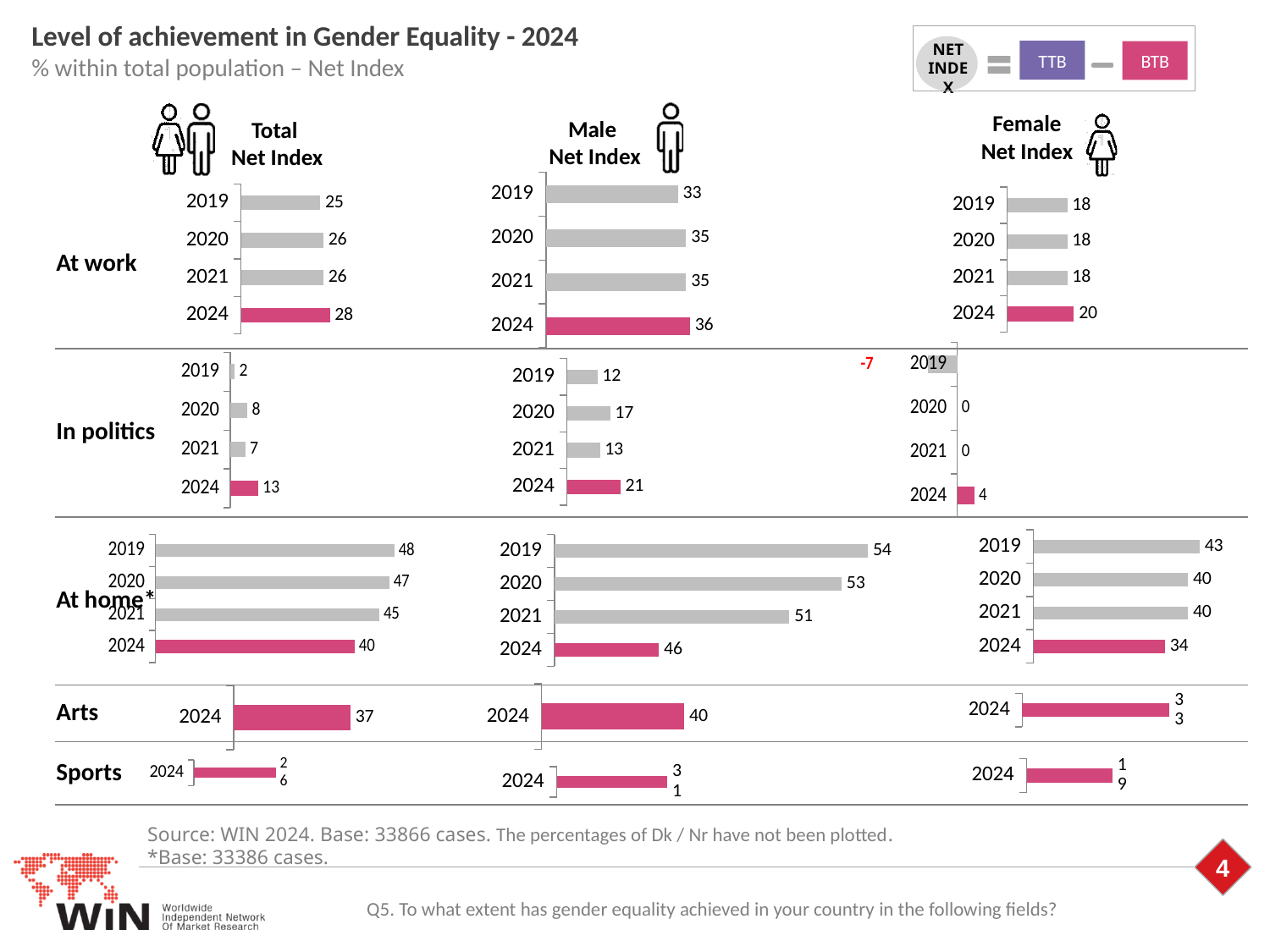
In the At home* row, Male Net Index chart, what is the difference between the 2019 and 2024 values? 8 In the At home* row, Female Net Index chart, do the values rise or fall from 2019 to 2024? fall In the In politics row, Total Net Index chart, which year has the highest value? 2024 In the At work row, Total Net Index chart, what is the value for 2024? 28 What kind of chart is used throughout the slide? bar chart In the In politics row, Total Net Index chart, which year has the lowest value? 2019 In the In politics row, Male Net Index chart, what is the difference between the 2024 and 2019 values? 9 In the At work row, Male Net Index chart, what is the value for 2019? 33 In the At work row, Female Net Index chart, what is the value for 2024? 20 In the In politics row, Female Net Index chart, what is the value for 2019? -7 In the Arts row, which is larger: the Total Net Index 2024 value or the Male Net Index 2024 value? Male Net Index In the At work row, Male Net Index chart, how many years are plotted? 4